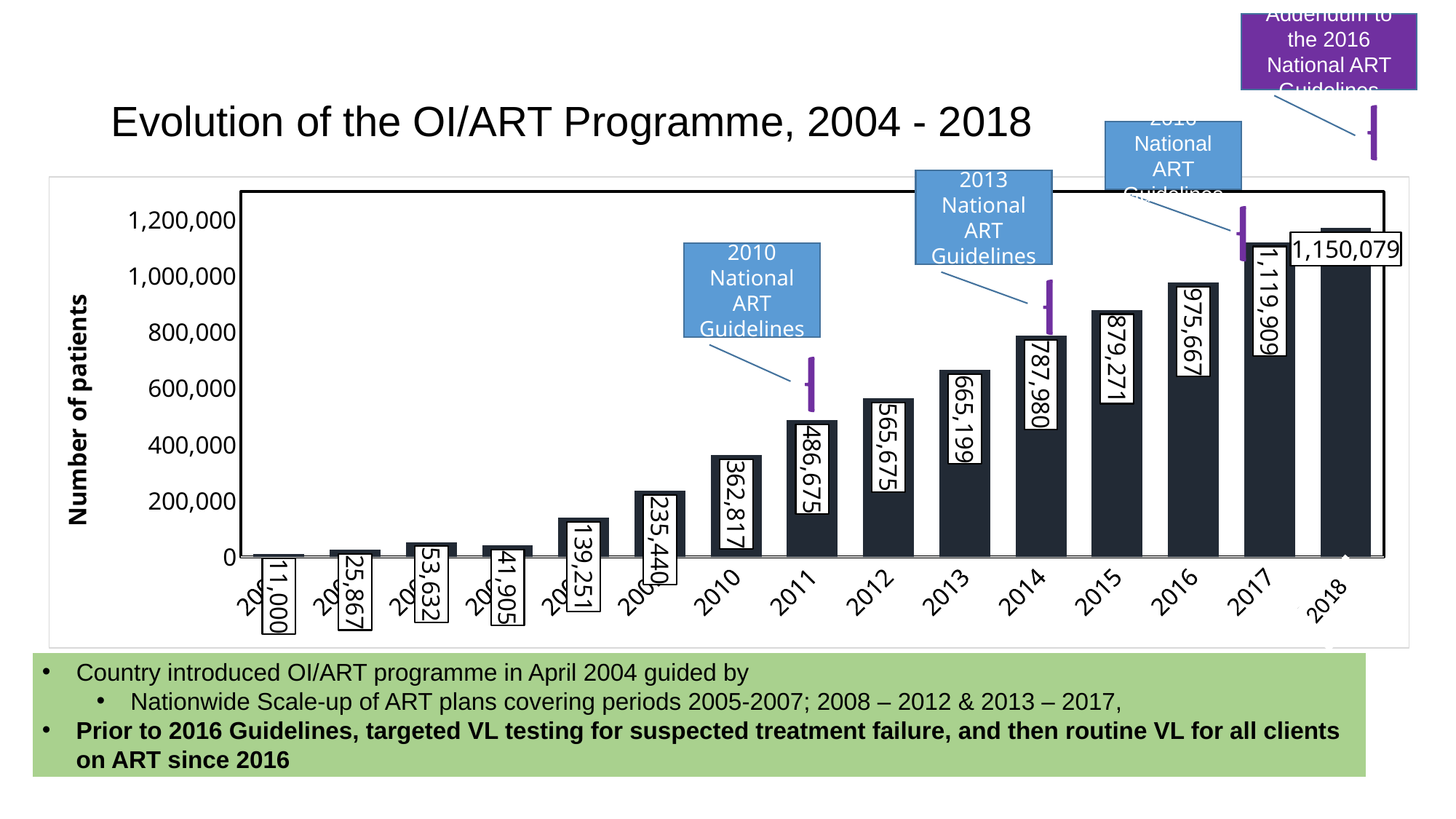
How many bars are shown in the chart? 15 What is the number of patients in 2011? 486,675 What is the value of the lowest bar in the chart? 11,000 What is the label of the vertical axis? Number of patients What is the difference in the number of patients between 2018 and 2017? 30,170 Which year has the highest number of patients? 2018 What is the number of patients in 2018? 1,150,079 What type of chart is shown on the slide? bar chart Is the number of patients in 2015 greater or less than 800,000? greater What is the number of patients in 2014? 787,980 What is the difference in the number of patients between 2016 and 2015? 96,396 Which year has more patients, 2012 or 2013? 2013